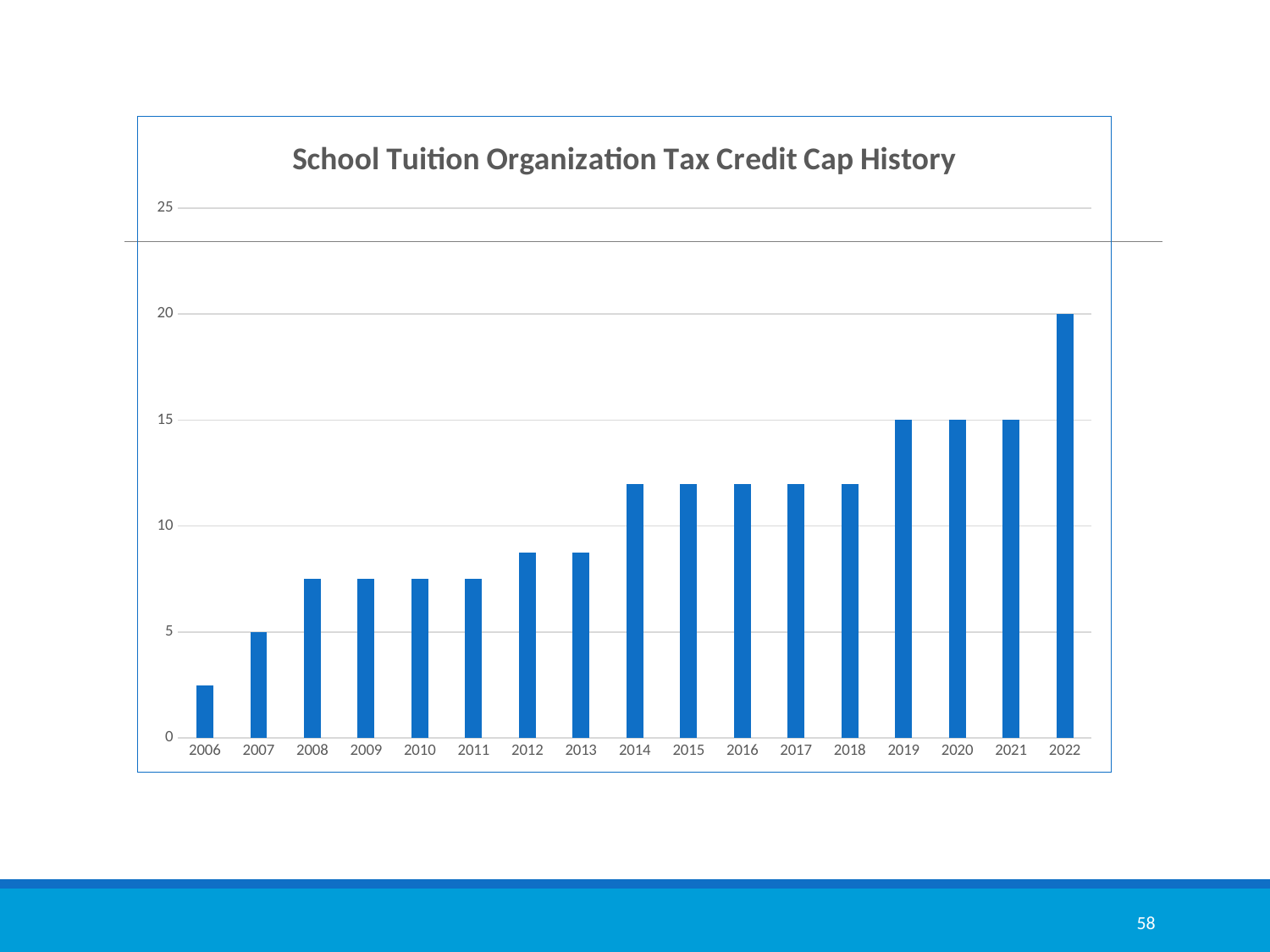
What is the value for 2022? 20 What type of chart is shown on the slide? bar chart Is the value for 2015 greater or less than 10? greater What is the value for 2020? 15 Do the values generally rise or fall from 2006 to 2022? rise What is the title of the chart? School Tuition Organization Tax Credit Cap History Is the value for 2006 greater or less than 5? less What is the value for 2007? 5 Which year has the lowest value in the chart? 2006 What is the difference between the values for 2022 and 2021? 5 Which year has the highest value in the chart? 2022 How many years are shown on the x axis of the chart? 17